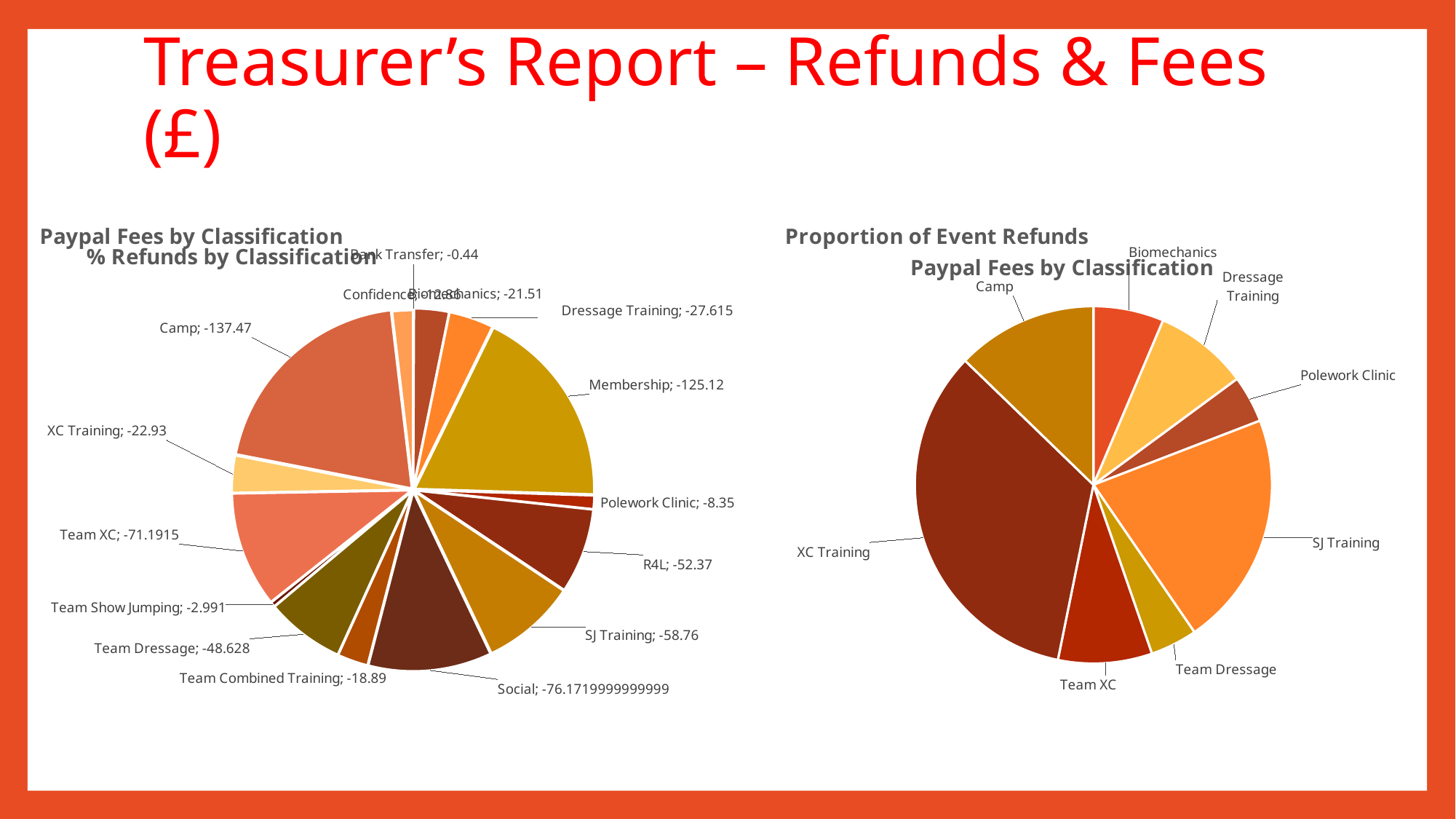
On the left pie chart, what is the value shown for Team XC? -71.1915 On the left pie chart, which category has the largest slice? Camp How many categories are shown on the right pie chart? 8 On the left pie chart, what is the value shown for Bank Transfer? -0.44 What type of chart is used on the right side of the slide? Pie chart On the left pie chart, what is the value shown for Membership? -125.12 On the left pie chart, what is the value shown for Camp? -137.47 On the left pie chart, which slice is larger, SJ Training or R4L? SJ Training On the right pie chart, which category has the largest slice? XC Training On the left pie chart, what is the difference between the Camp value and the Membership value? 12.35 On the left pie chart, what is the value shown for Team Dressage? -48.628